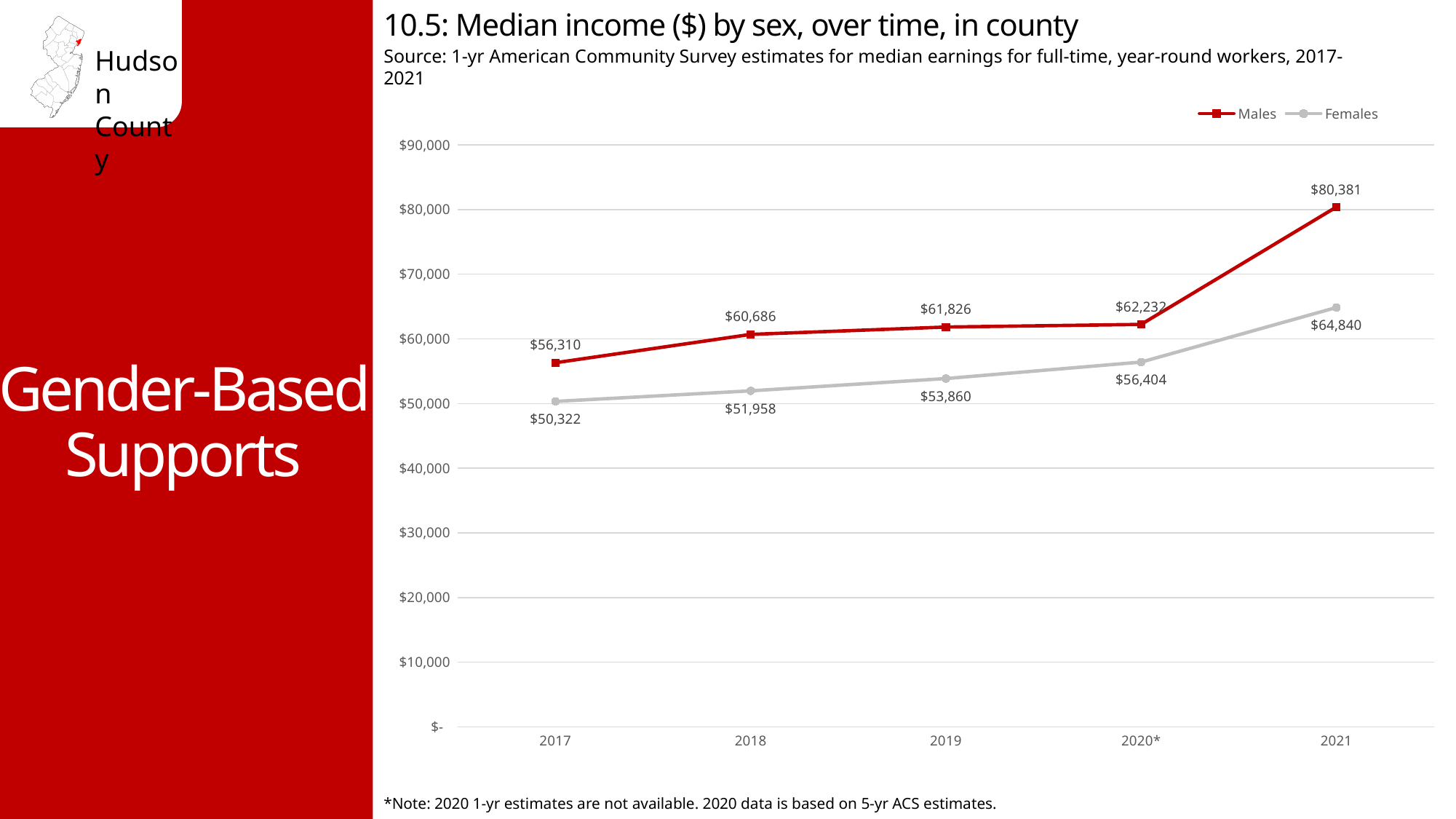
How many years are shown on the x axis? 5 What was the median income for Females in 2017? $50,322 What kind of chart is shown on the slide? Line chart What was the median income for Females in 2020*? $56,404 What was the median income for Males in 2021? $80,381 Is the median income for Females in 2021 greater or less than $60,000? greater In which year was the median income for Females lowest? 2017 Which series had the higher median income in 2019, Males or Females? Males In which year was the median income for Males highest? 2021 Does the median income for Females rise or fall from 2017 to 2021? Rise What is the difference between the Males and Females median income in 2021? $15,541 How many series does the legend list? 2